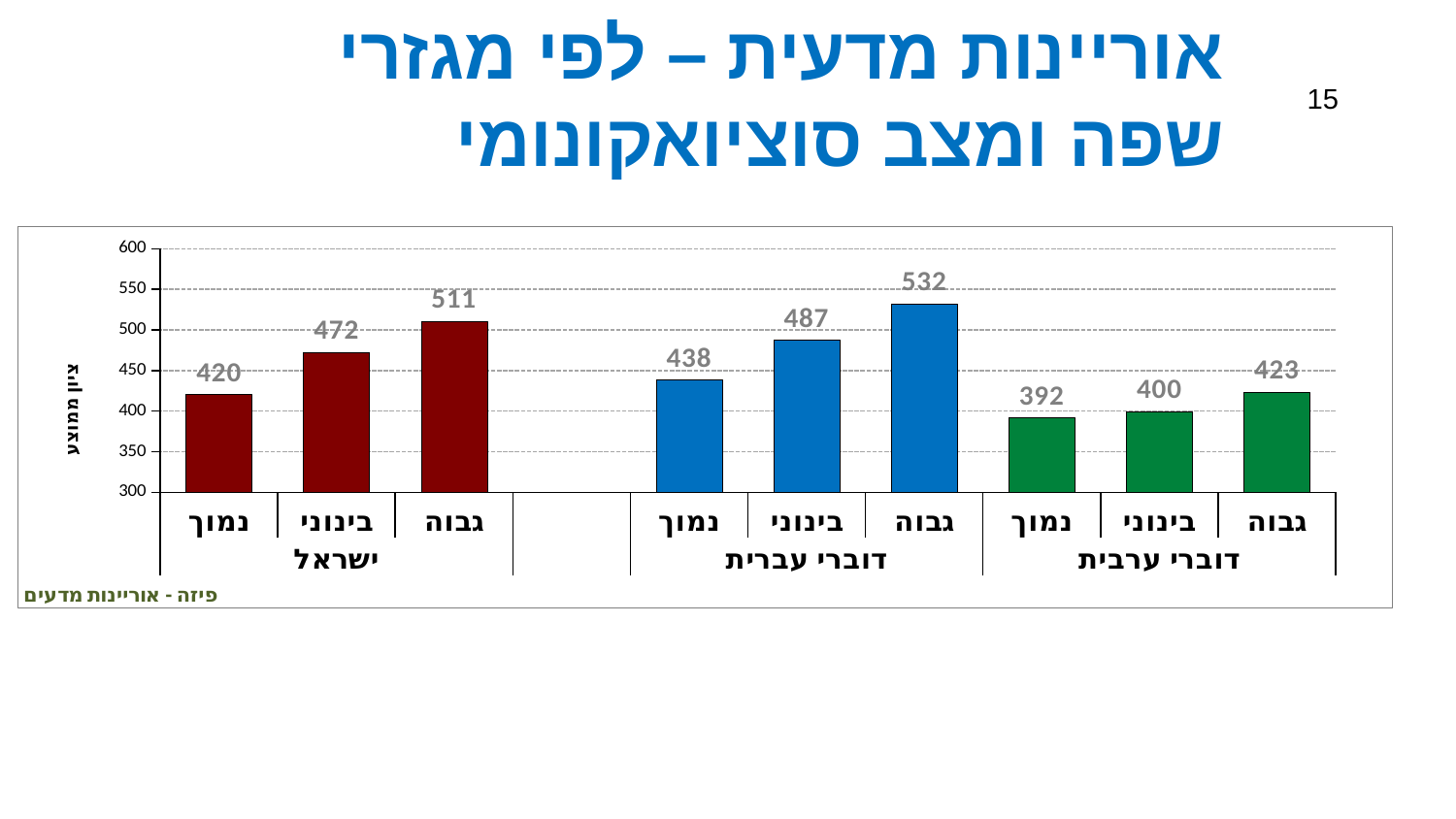
What is the value for the נמוך bar in the ישראל group? 420 What is the value for the גבוה bar in the דוברי עברית group? 532 What is the label of the vertical axis? ציון ממוצע Which bar has the highest value on the chart? גבוה in דוברי עברית (532) Which is larger: the בינוני bar in ישראל or the בינוני bar in דוברי עברית? בינוני in דוברי עברית (487) Is the value for the גבוה bar in the דוברי ערבית group greater or less than 450? less What is the difference between the גבוה bars of דוברי עברית and דוברי ערבית? 109 What kind of chart is shown on the slide? bar chart What is the value for the בינוני bar in the דוברי ערבית group? 400 How many bars are plotted on the chart in total? 9 Which bar has the lowest value on the chart? נמוך in דוברי ערבית (392) What is the difference between the גבוה and נמוך bars in the ישראל group? 91